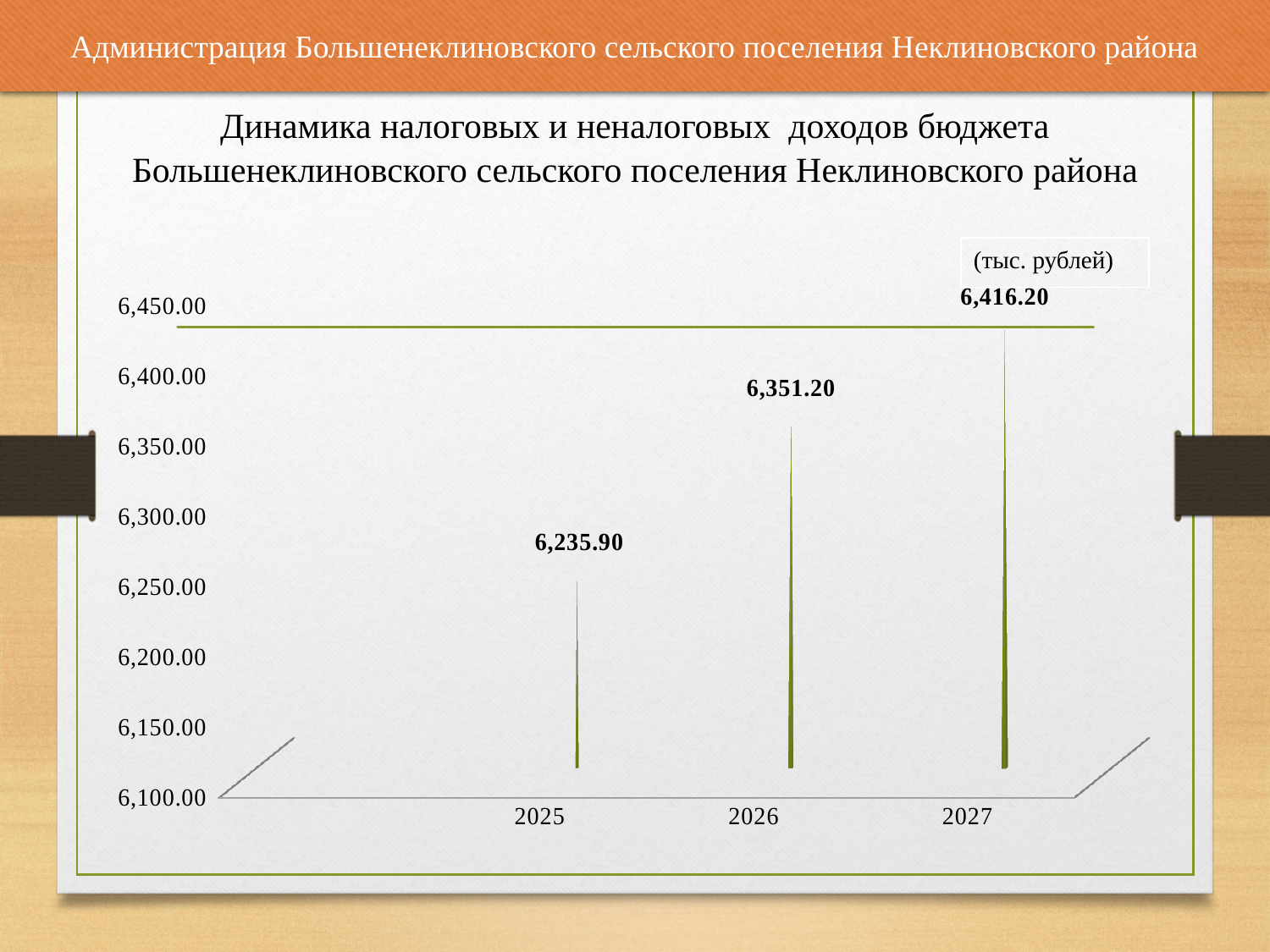
What is the value shown for 2027? 6,416.20 What is the value shown for 2025? 6,235.90 What kind of chart is shown on the slide? bar chart What is the difference between the values for 2027 and 2026? 65.00 Which is larger, the value for 2025 or the value for 2027? 2027 Which year has the lowest value? 2025 What is the value shown for 2026? 6,351.20 Is the value for 2026 greater or less than 6,300.00? greater What is the difference between the values for 2026 and 2025? 115.30 How many years are shown on the x axis? 3 Do the values rise or fall from 2025 to 2027? rise Which year has the highest value? 2027